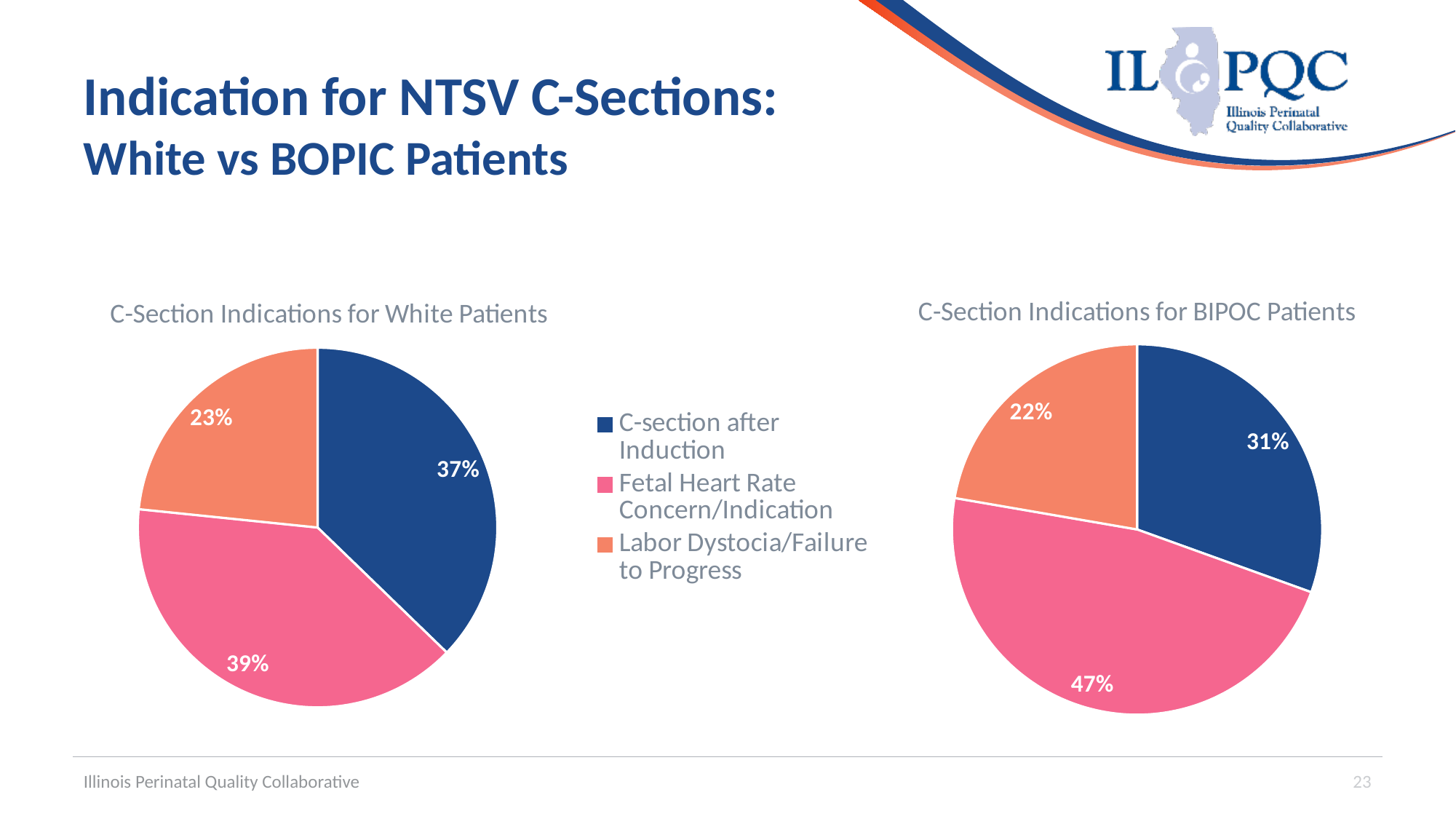
Which colour represents Labor Dystocia/Failure to Progress in the legend? Orange In the 'C-Section Indications for BIPOC Patients' chart, which indication has the largest slice? Fetal Heart Rate Concern/Indication How many slices does the 'C-Section Indications for BIPOC Patients' chart have? 3 How many entries does the shared legend between the two charts list? 3 In the 'C-Section Indications for White Patients' chart, which indication has the smallest slice? Labor Dystocia/Failure to Progress In the 'C-Section Indications for White Patients' chart, is the share for C-section after Induction greater or less than 30%? greater In the 'C-Section Indications for BIPOC Patients' chart, what share is labelled for C-section after Induction? 31% In the 'C-Section Indications for White Patients' chart, what share is labelled for Labor Dystocia/Failure to Progress? 23% In the 'C-Section Indications for BIPOC Patients' chart, what is the difference between the Fetal Heart Rate Concern/Indication share and the C-section after Induction share? 16% Is the share for C-section after Induction larger in the White Patients chart or the BIPOC Patients chart? White Patients chart What type of chart is used for 'C-Section Indications for White Patients'? Pie chart In the 'C-Section Indications for White Patients' chart, what share is labelled for Fetal Heart Rate Concern/Indication? 39%